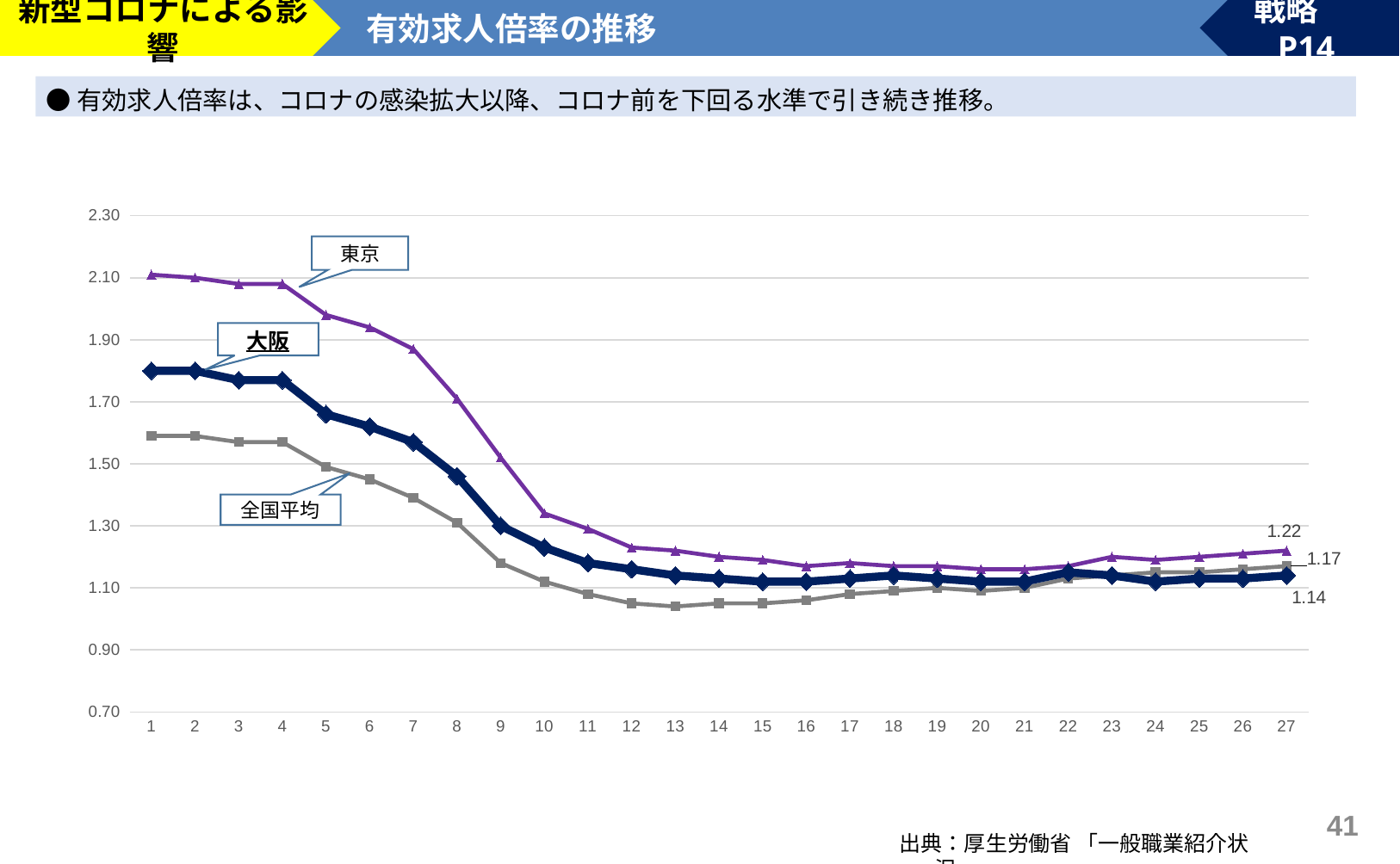
What is the value for 東京 at point 27? 1.22 What is the value for 大阪 at point 27? 1.14 What is the value for 全国平均 at point 27? 1.17 Do the 大阪 values rise or fall from point 1 to point 13? fall How many series are plotted in the chart? 3 At point 27, which is larger: the 全国平均 value or the 大阪 value? 全国平均 At point 27, what is the difference between the 東京 value and the 大阪 value? 0.08 Is the value for 全国平均 at point 13 greater or less than 1.10? less How many points are plotted along the x axis for each series? 27 Is the value for 東京 at point 7 greater or less than 1.70? greater Which series has the highest value at point 1? 東京 What kind of chart is shown on the slide? line chart